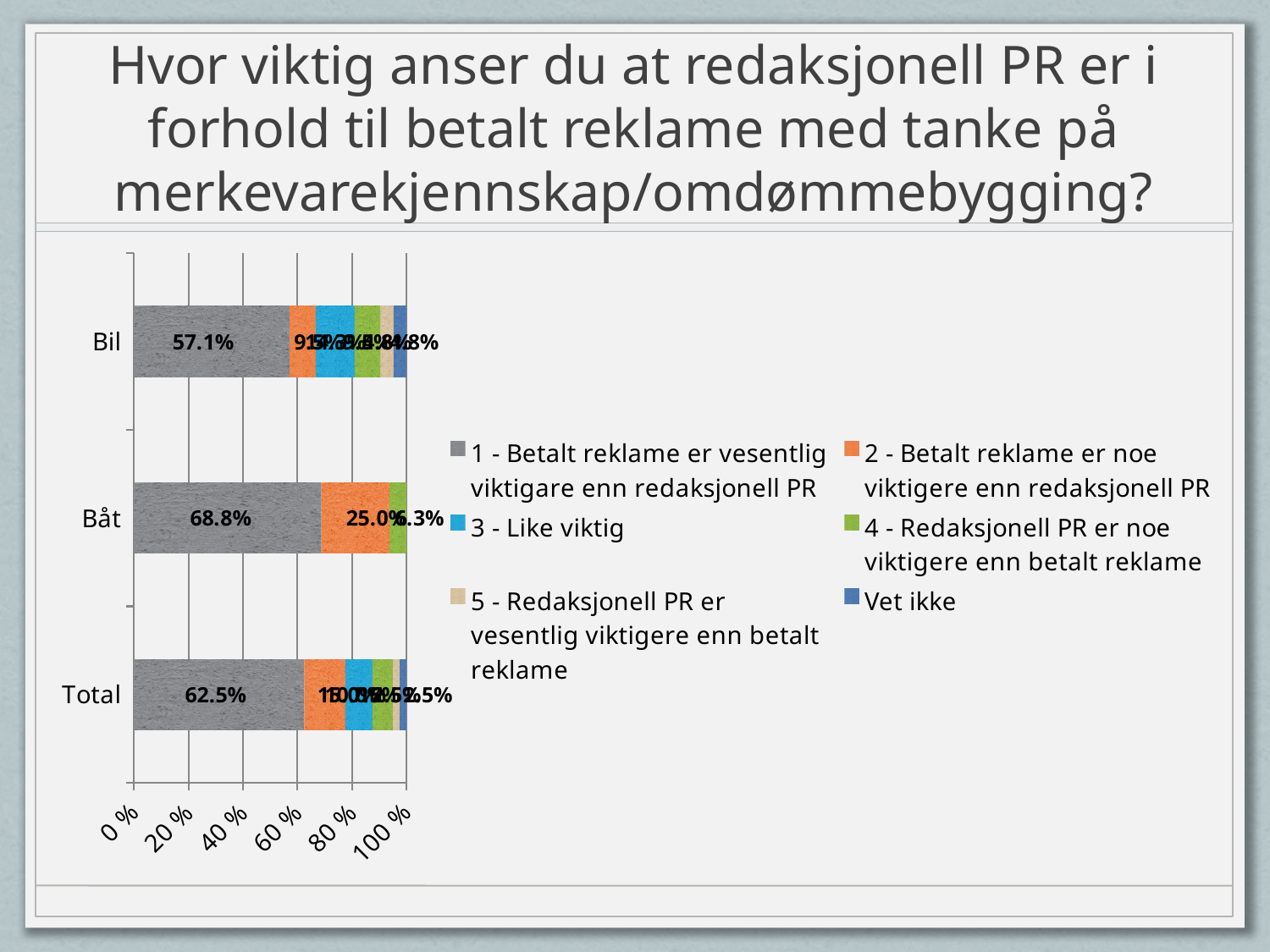
Is the value of '1 - Betalt reklame er vesentlig viktigare enn redaksjonell PR' for Total greater or less than 60 %? greater How many categories are shown on the vertical axis of the chart? 3 What is the value of '2 - Betalt reklame er noe viktigere enn redaksjonell PR' for Båt? 25.0% Which category has the lowest value for '1 - Betalt reklame er vesentlig viktigare enn redaksjonell PR'? Bil How many series does the chart legend list? 6 What is the value of '1 - Betalt reklame er vesentlig viktigare enn redaksjonell PR' for Båt? 68.8% What kind of chart is shown on the slide? stacked bar chart What is the value of '1 - Betalt reklame er vesentlig viktigare enn redaksjonell PR' for Total? 62.5% Which category has the highest value for '1 - Betalt reklame er vesentlig viktigare enn redaksjonell PR'? Båt Which legend entry is shown in grey? 1 - Betalt reklame er vesentlig viktigare enn redaksjonell PR What is the difference between the Båt and Bil values for '1 - Betalt reklame er vesentlig viktigare enn redaksjonell PR'? 11.7% What is the value of '1 - Betalt reklame er vesentlig viktigare enn redaksjonell PR' for Bil? 57.1%